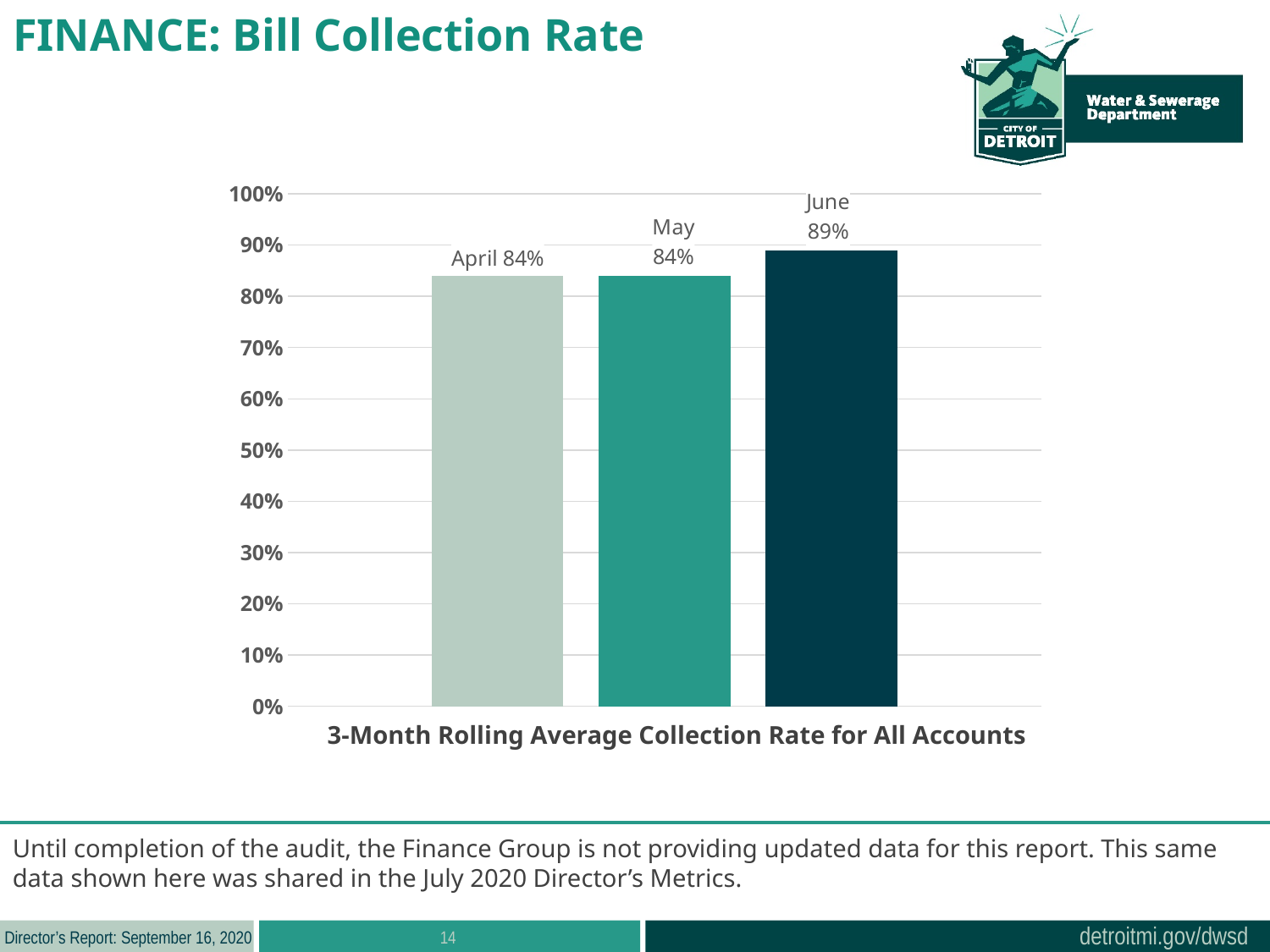
What is the label shown beneath the bars on the x axis? 3-Month Rolling Average Collection Rate for All Accounts Is the collection rate for April greater or less than 90%? less Do the collection rates rise or fall from April to June? rise Is the collection rate for June greater or less than 80%? greater What is the collection rate for June? 89% What kind of chart is shown on the slide? bar chart How many months are shown in the chart? 3 Which month has the highest collection rate? June What is the collection rate for May? 84% What is the collection rate for April? 84% What is the highest value shown on the y axis? 100% What is the difference between the June and May collection rates? 5%